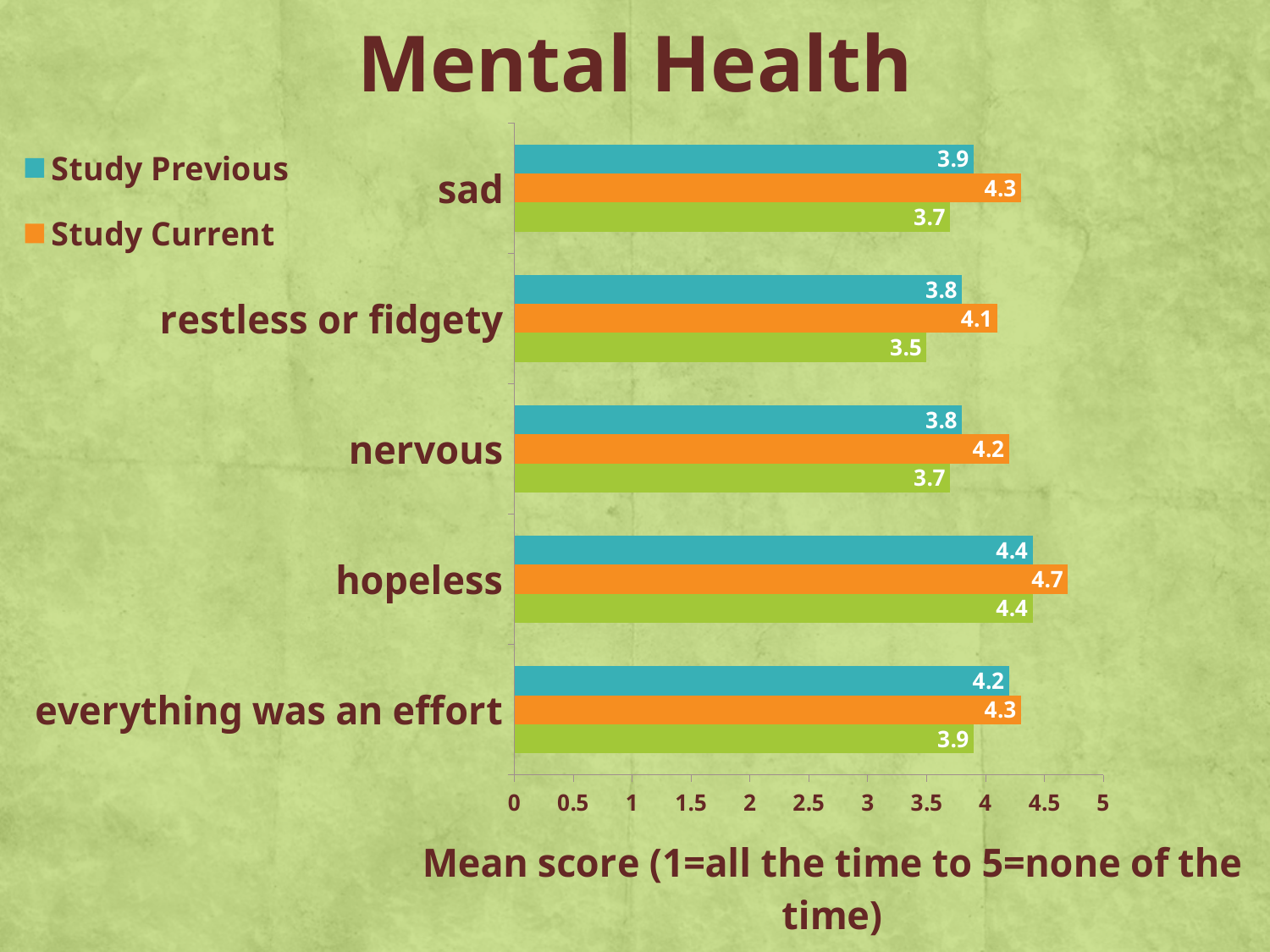
Is the Study Current value for "hopeless" greater or less than 4.5? greater How many categories are shown on the chart? 5 Which category has the highest Study Current mean score? hopeless Which is larger for "hopeless": the Study Previous or the Study Current mean score? Study Current What is the Study Previous mean score for "nervous"? 3.8 What is the difference between the Study Current and Study Previous mean scores for "sad"? 0.4 What is the Study Current mean score for "sad"? 4.3 What is the Study Previous mean score for "everything was an effort"? 4.2 How many series does the legend list? 2 Which category has the lowest Study Current mean score? restless or fidgety What kind of chart is shown on the slide? bar chart What is the difference between the Study Current and Study Previous mean scores for "nervous"? 0.4